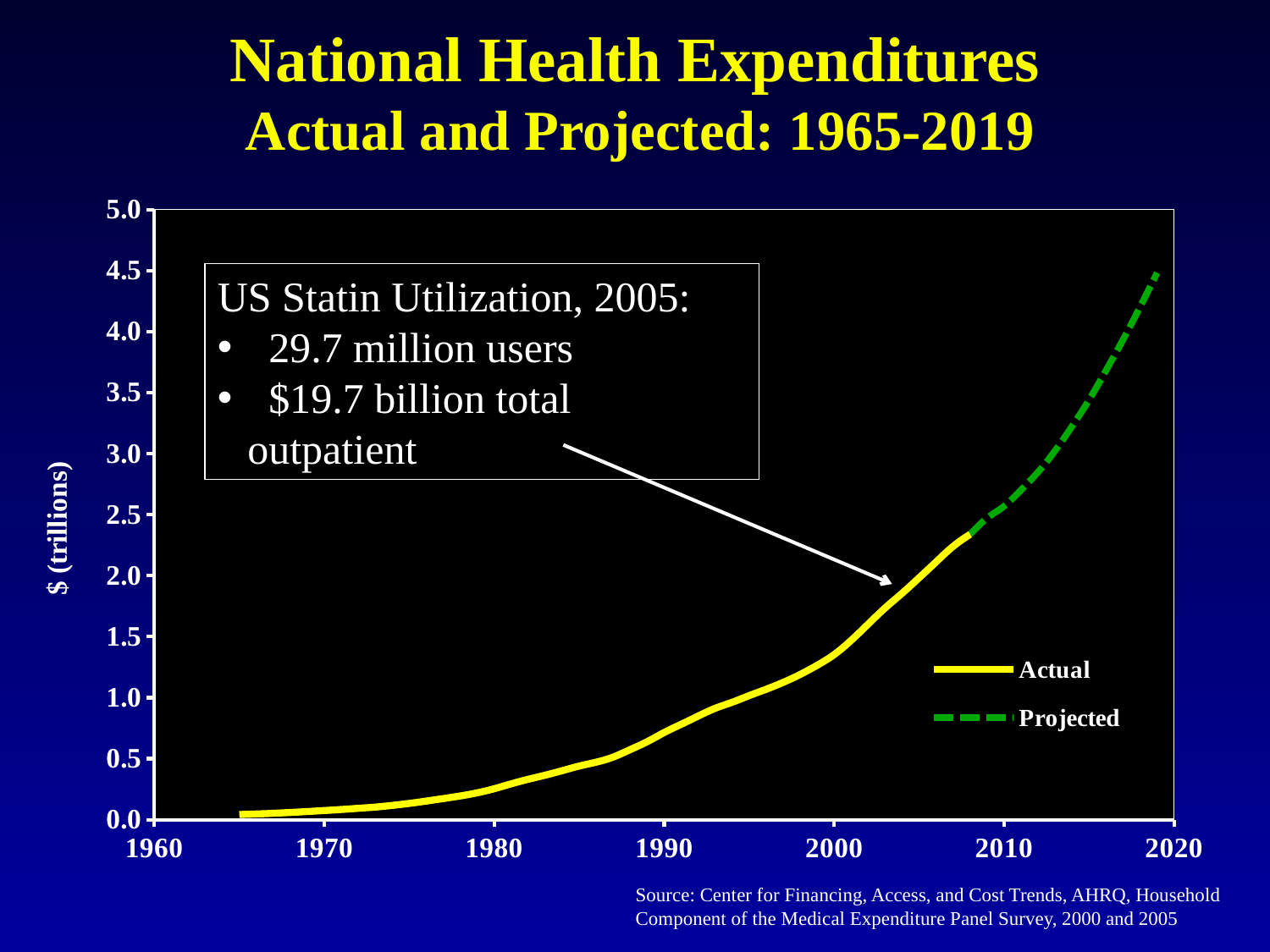
Is the value for 2000 greater or less than 1.0? greater How many series does the legend list? 2 What is the label on the y axis of the chart? $ (trillions) Is the value for 2010 greater or less than 2.0? greater Do national health expenditures rise or fall from 1965 to 2019 along the x axis? rise What kind of chart is shown on the slide? line chart Is the projected value for 2019 greater or less than 4.0? greater Which is larger, the value for 2010 or the value for 1990? 2010 What are the two series named in the legend? Actual and Projected Which year shown on the x axis has the highest expenditure value? 2019